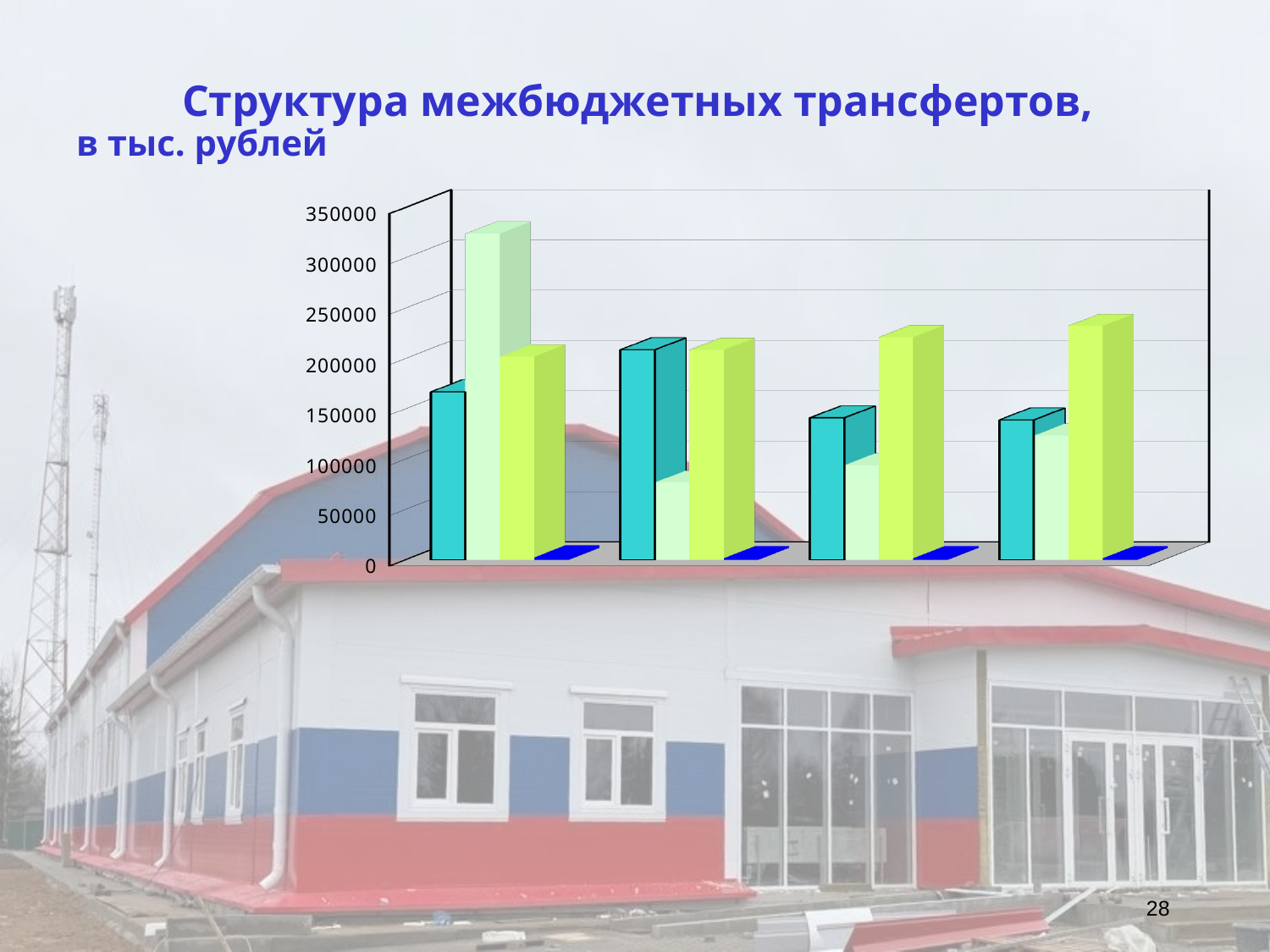
In what units are the values on the chart expressed, according to the title? тыс. рублей Is the value of the pale green bar in the first (leftmost) group greater or less than 300000? greater What is the highest value shown on the vertical axis? 350000 How many groups of bars are plotted along the x axis? 4 What kind of chart is shown on the slide? bar chart Is the value of the cyan bar in the first (leftmost) group greater or less than 150000? greater How many bars are there in each group? 4 Which bar in the first (leftmost) group is the tallest: cyan, pale green, yellow-green or blue? pale green What is the title of the chart on the slide? Структура межбюджетных трансфертов, в тыс. рублей Is the value of the yellow-green bar in the fourth (rightmost) group greater or less than 200000? greater Is the pale green bar in the first group larger or smaller than the pale green bar in the second group? larger